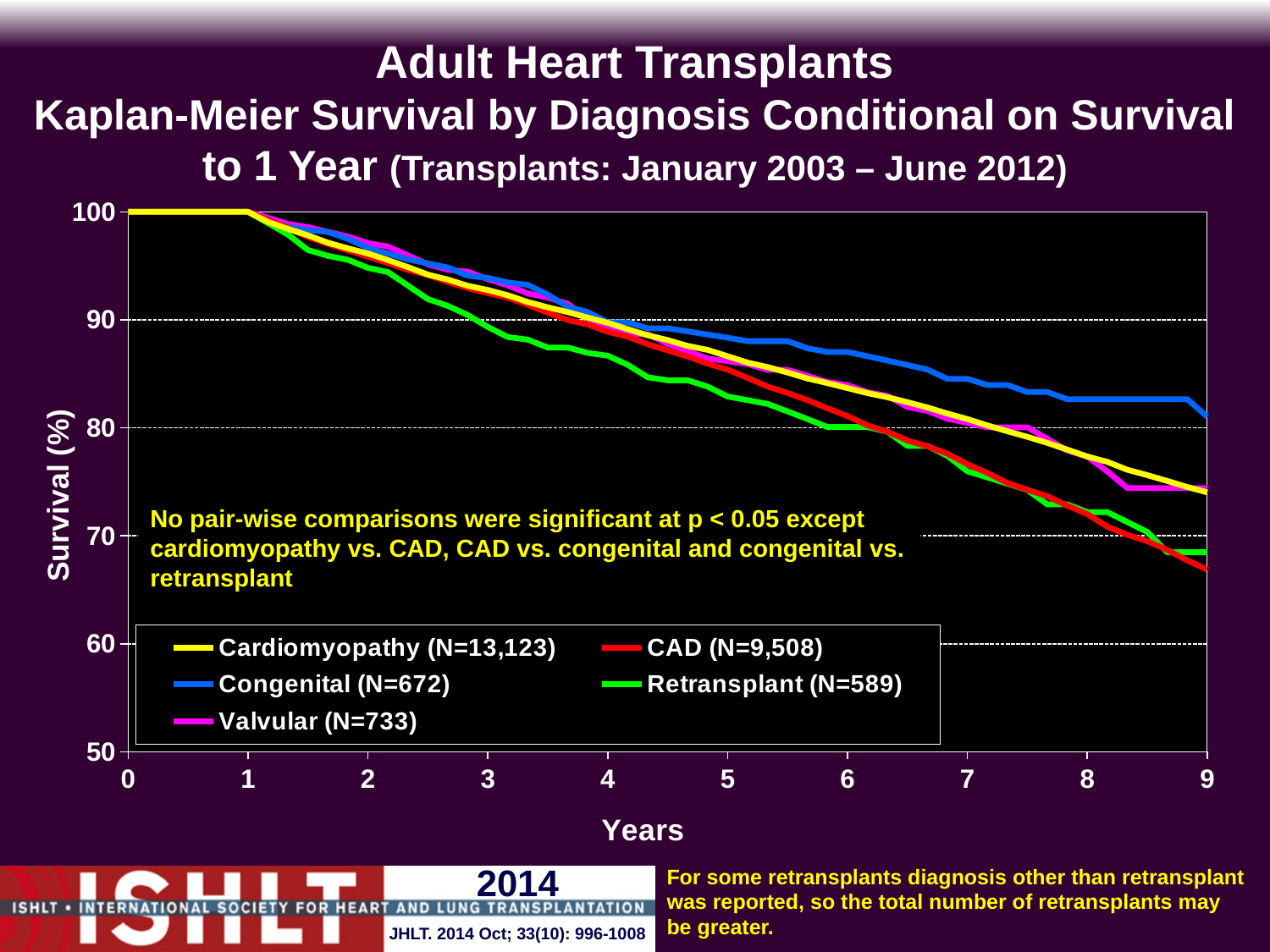
Do the survival curves rise or fall as years increase? fall What is the N shown in the legend for Cardiomyopathy? 13,123 At year 3, which is larger: the survival for Congenital or for Retransplant? Congenital What kind of chart is shown on the slide? line chart Which diagnosis group has the highest survival at year 9? Congenital What is the survival (%) for Congenital at year 0? 100 What is the survival (%) for Cardiomyopathy at year 1? 100 How many series does the legend list? 5 Is the survival for Congenital at year 5 greater or less than 90? less Is the survival for Congenital at year 9 greater or less than 80? greater Is the survival for Cardiomyopathy at year 9 greater or less than 70? greater